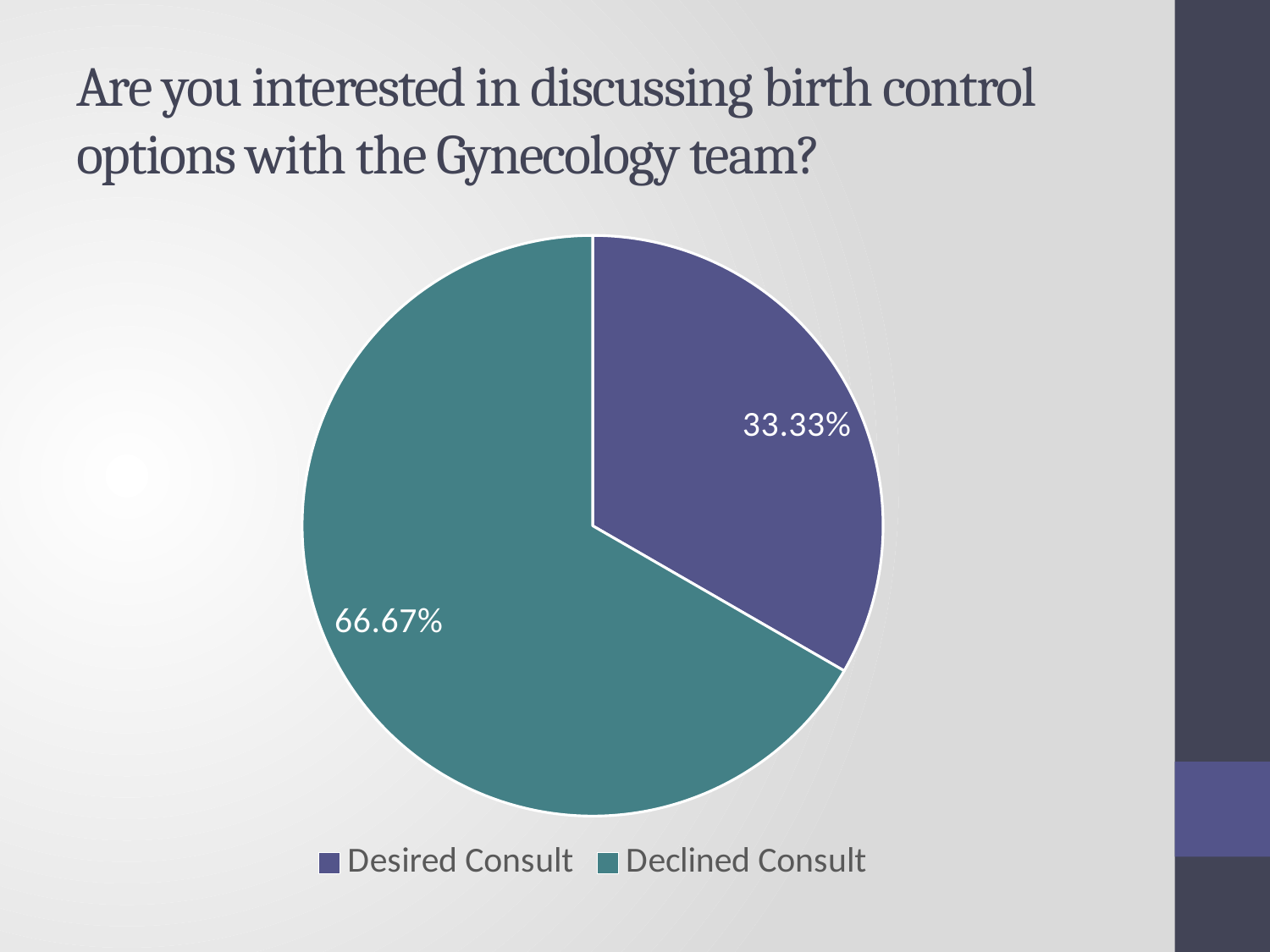
How many entries does the legend list? 2 Which slice of the pie is the largest? Declined Consult What kind of chart is shown on the slide? pie chart What colour is the Declined Consult slice? teal What is the title of the slide above the chart? Are you interested in discussing birth control options with the Gynecology team? Which slice of the pie is the smallest? Desired Consult What share of the pie is Declined Consult? 66.67% What share of the pie is Desired Consult? 33.33% Which is larger, Desired Consult or Declined Consult? Declined Consult What is the difference in percentage points between Declined Consult and Desired Consult? 33.34% How many slices does the pie chart have? 2